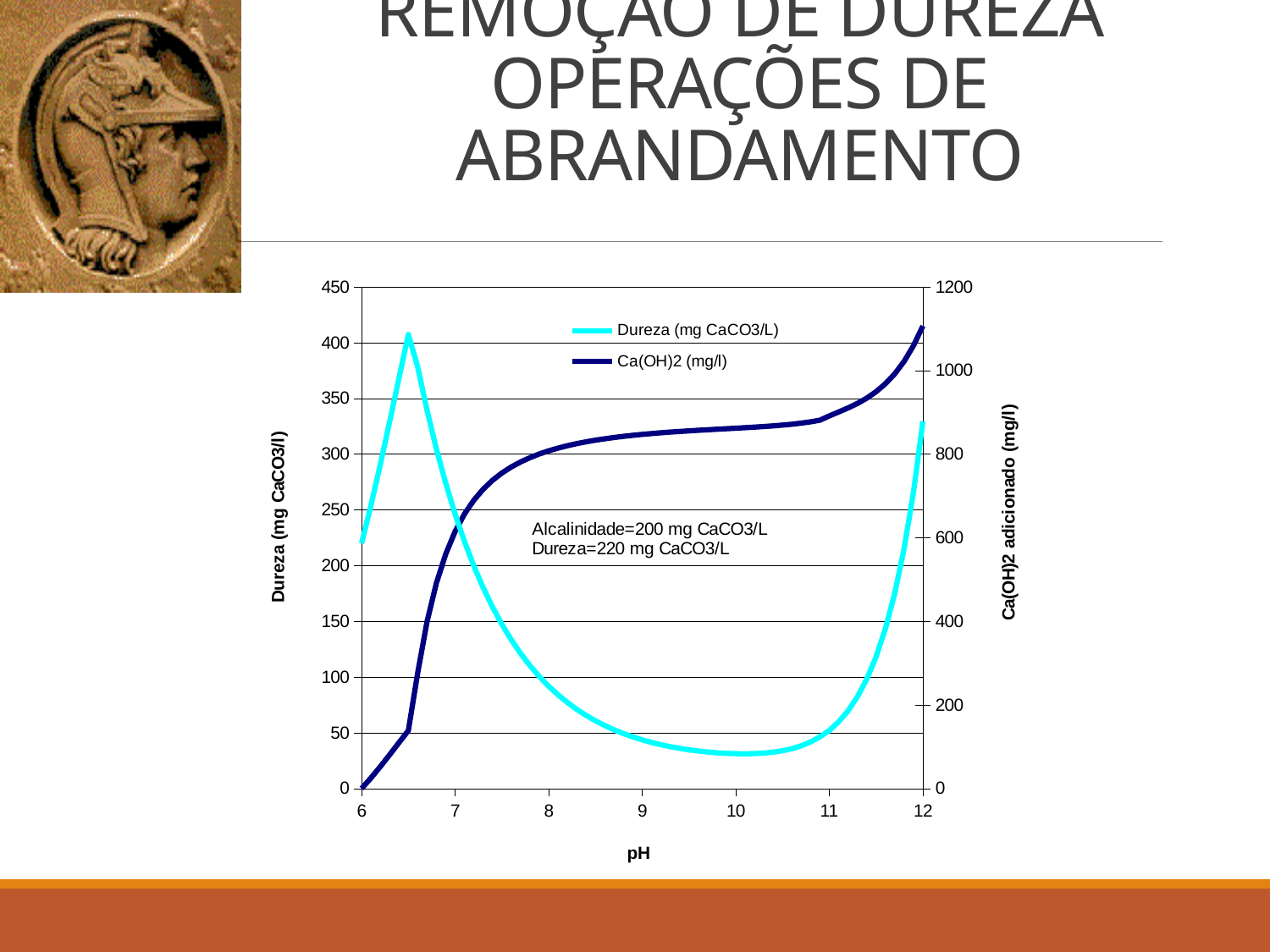
Does the Ca(OH)2 (mg/l) series rise or fall as pH increases from 6 to 12? rises Is the Ca(OH)2 (mg/l) value at pH 6.5 greater or less than 200? less Does the Dureza (mg CaCO3/L) series rise or fall as pH increases from 7 to 10? falls How many series does the chart legend list? 2 Is the Ca(OH)2 (mg/l) value at pH 12 greater or less than 1000? greater Is the Ca(OH)2 (mg/l) value at pH 9 greater or less than 800? greater What kind of chart is shown on the slide? line chart What is the title of the right-hand vertical axis? Ca(OH)2 adicionado (mg/l) What is the label of the x axis of the chart? pH What is the range of the pH axis shown on the chart? 6 to 12